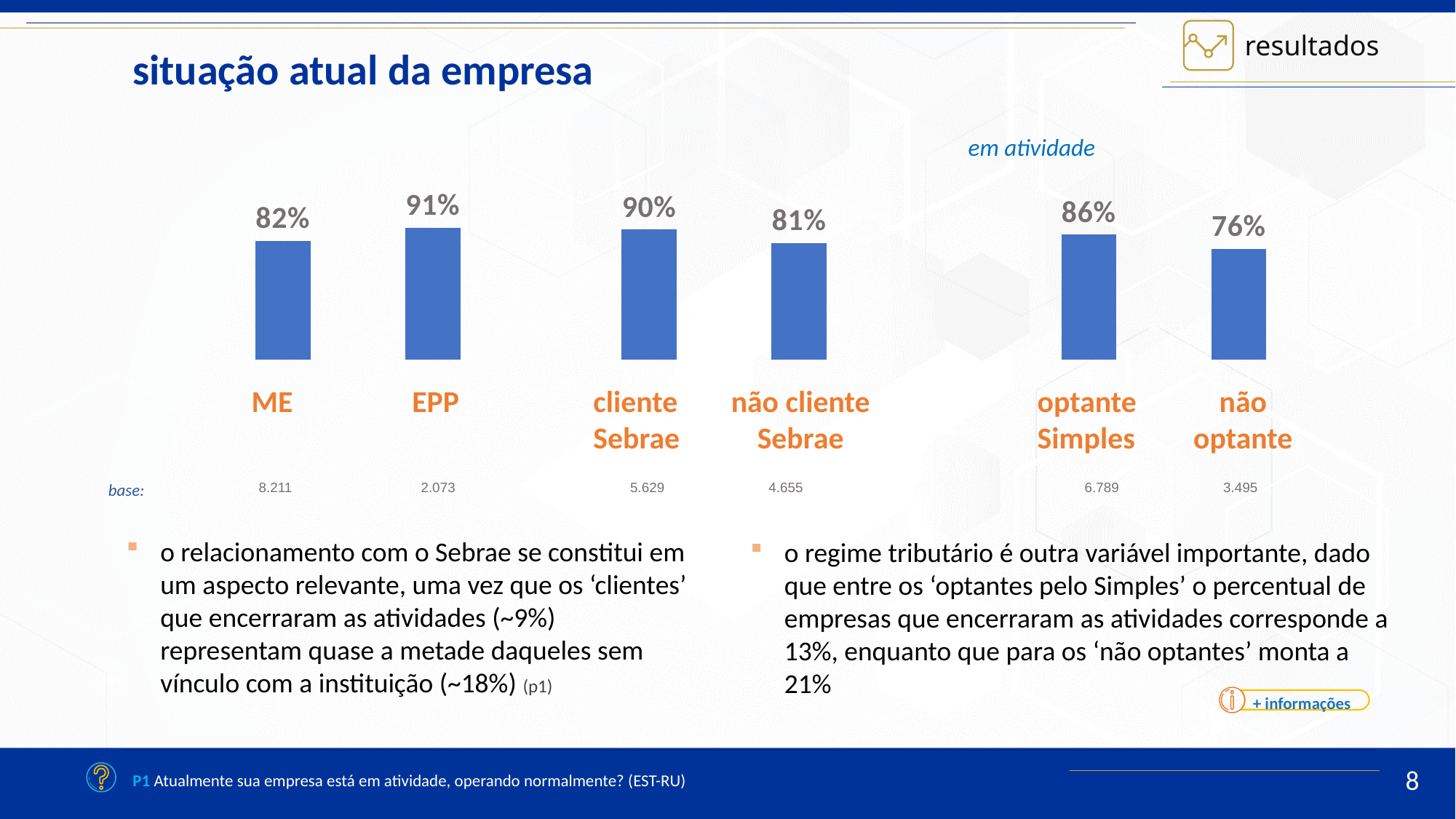
What kind of chart is shown on the slide? bar chart What percentage is shown for 'não cliente Sebrae'? 81% What is the base (sample size) shown for 'cliente Sebrae'? 5.629 What percentage is shown for ME? 82% How many categories are shown in the chart? 6 What is the difference between the percentages for 'optante Simples' and 'não optante'? 10% Which category has the lowest percentage? não optante Which is larger, the percentage for ME or for EPP? EPP What is the difference between the percentages for 'cliente Sebrae' and 'não cliente Sebrae'? 9% Which category has the highest percentage? EPP What percentage is shown for 'optante Simples'? 86% What percentage is shown for EPP? 91%